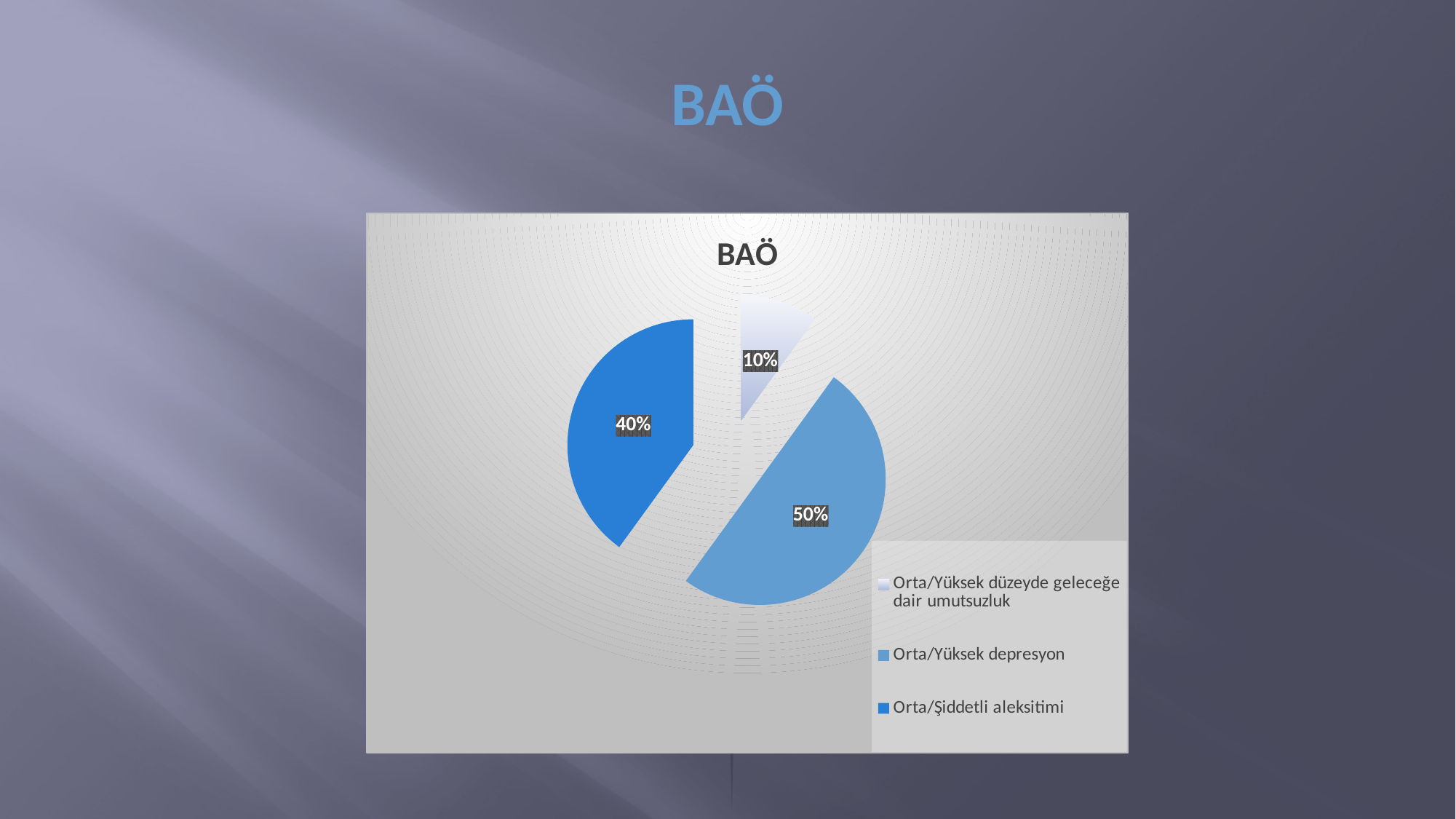
Which category has the smallest slice of the pie? Orta/Yüksek düzeyde geleceğe dair umutsuzluk What share of the pie is labelled Orta/Yüksek depresyon? 50% What is the difference in percentage points between Orta/Şiddetli aleksitimi and Orta/Yüksek düzeyde geleceğe dair umutsuzluk? 30% What kind of chart is shown on the slide? pie chart What share of the pie is labelled Orta/Yüksek düzeyde geleceğe dair umutsuzluk? 10% Which category has the largest slice of the pie? Orta/Yüksek depresyon What is the difference in percentage points between Orta/Yüksek depresyon and Orta/Şiddetli aleksitimi? 10% What share of the pie is labelled Orta/Şiddetli aleksitimi? 40% How many slices does the pie chart have? 3 How many entries does the legend list? 3 Which is larger, the slice for Orta/Şiddetli aleksitimi or the slice for Orta/Yüksek düzeyde geleceğe dair umutsuzluk? Orta/Şiddetli aleksitimi What is the title of the chart? BAÖ